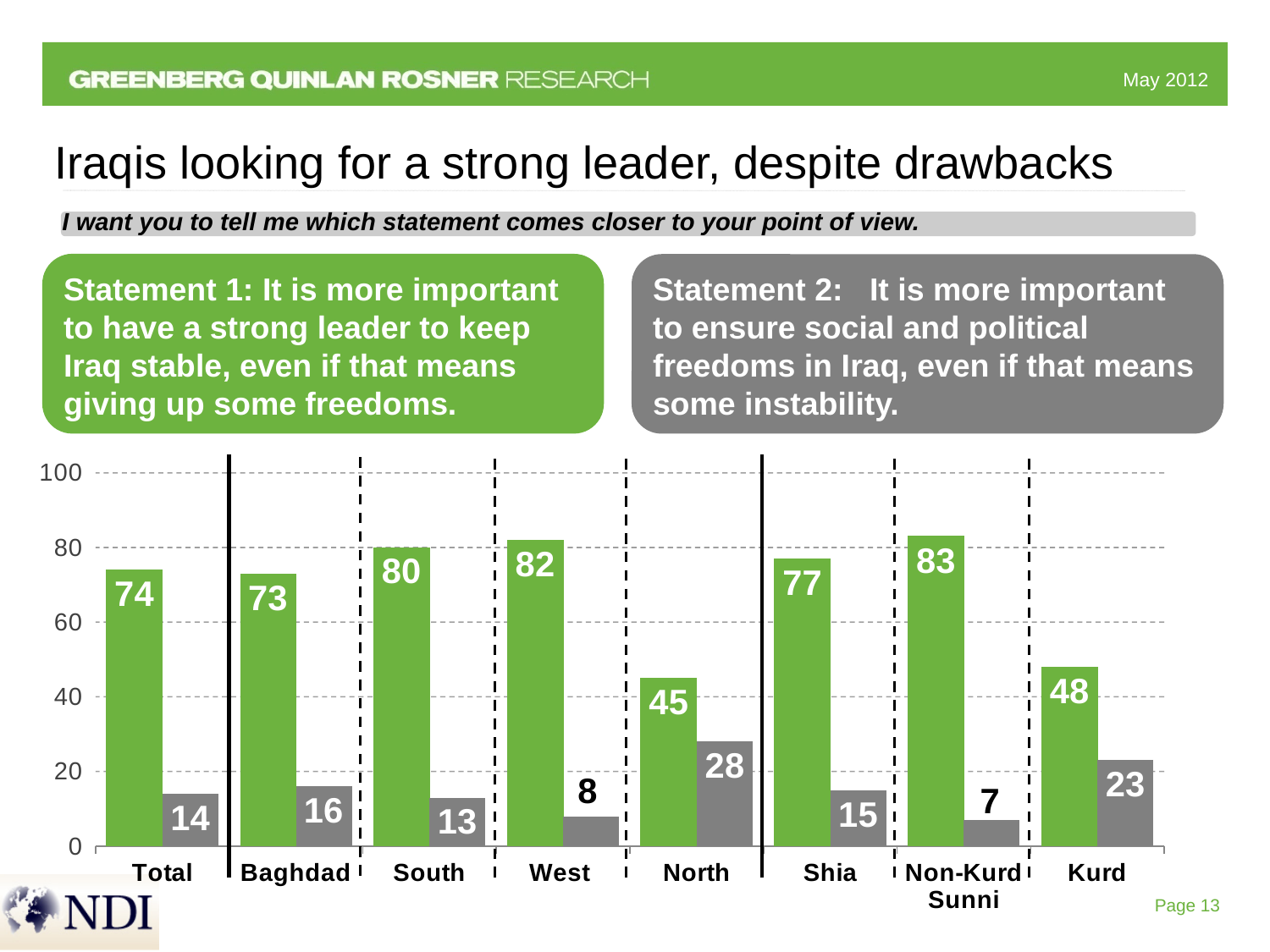
Which category has the lowest value for Statement 2 (freedoms)? Non-Kurd Sunni What is the difference between the Statement 1 values for Non-Kurd Sunni and Kurd? 35 Which is larger: the Statement 1 value for Shia or the Statement 1 value for Baghdad? Shia What is the value for Statement 2 (freedoms) for North? 28 What is the value for Statement 1 (strong leader) for Total? 74 Which category has the lowest value for Statement 1 (strong leader)? North What is the difference between the Statement 1 and Statement 2 values for West? 74 How many categories are shown on the x axis? 8 What kind of chart is shown on the slide? Bar chart What colour are the bars representing Statement 1? Green What is the value for Statement 1 (strong leader) for Kurd? 48 Which category has the highest value for Statement 1 (strong leader)? Non-Kurd Sunni